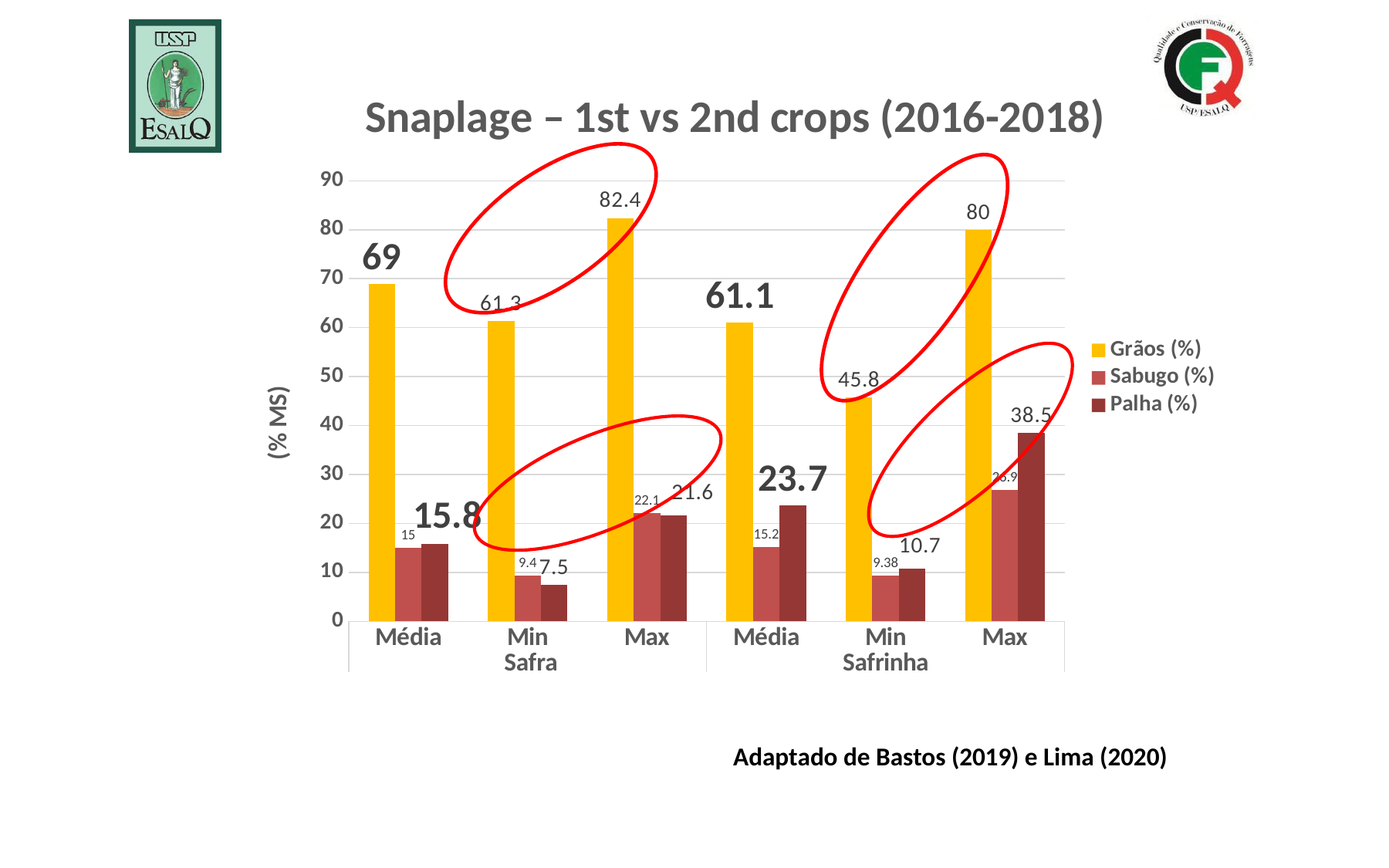
Is the Grãos (%) value for Min under Safrinha greater or less than 50? less Which category has the highest Grãos (%) value? Max (Safra) What is the Palha (%) value for Max under Safrinha? 38.5 What is the Grãos (%) value for Max under Safrinha? 80 What is the Sabugo (%) value for Min under Safrinha? 9.38 What is the Grãos (%) value for Média under Safra? 69 Which is larger: the Palha (%) value for Média under Safra or for Média under Safrinha? Média under Safrinha What is the difference between the Grãos (%) values for Max under Safra and Max under Safrinha? 2.4 Which category has the lowest Palha (%) value? Min (Safra) What is the title of the chart? Snaplage – 1st vs 2nd crops (2016-2018) How many series does the legend list? 3 What type of chart is shown on the slide? bar chart